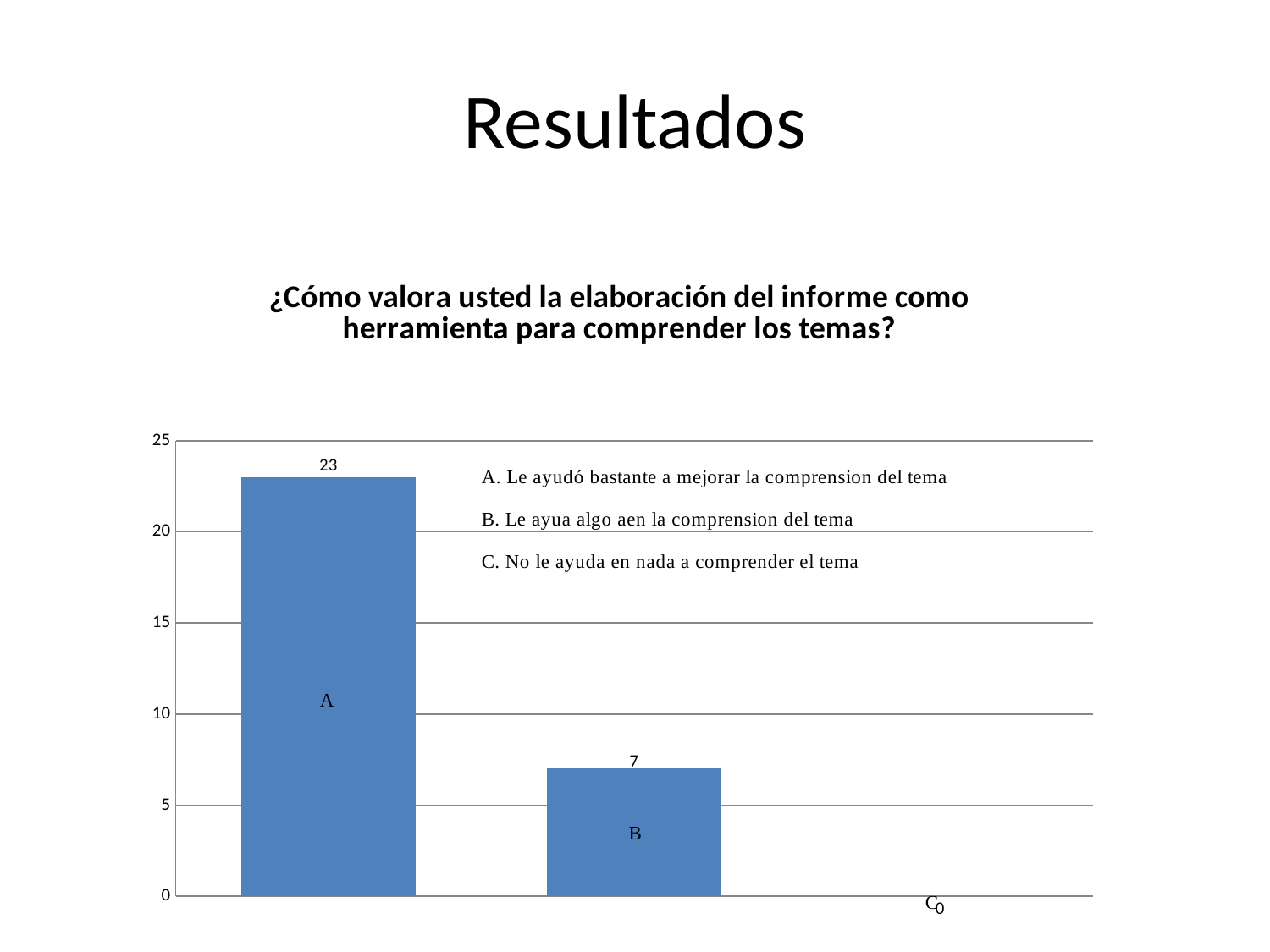
Is the value for A greater or less than 20? greater What is the difference between the values for A and B? 16 What is the value for category C? 0 Which is larger, the value for A or the value for B? A What is the value for category B? 7 Which category has the lowest value? C What is the value for category A? 23 Which category has the highest value? A What kind of chart is shown on the slide? bar chart What is the title of the chart? ¿Cómo valora usted la elaboración del informe como herramienta para comprender los temas? Is the value for B greater or less than 10? less How many categories are shown in the chart? 3